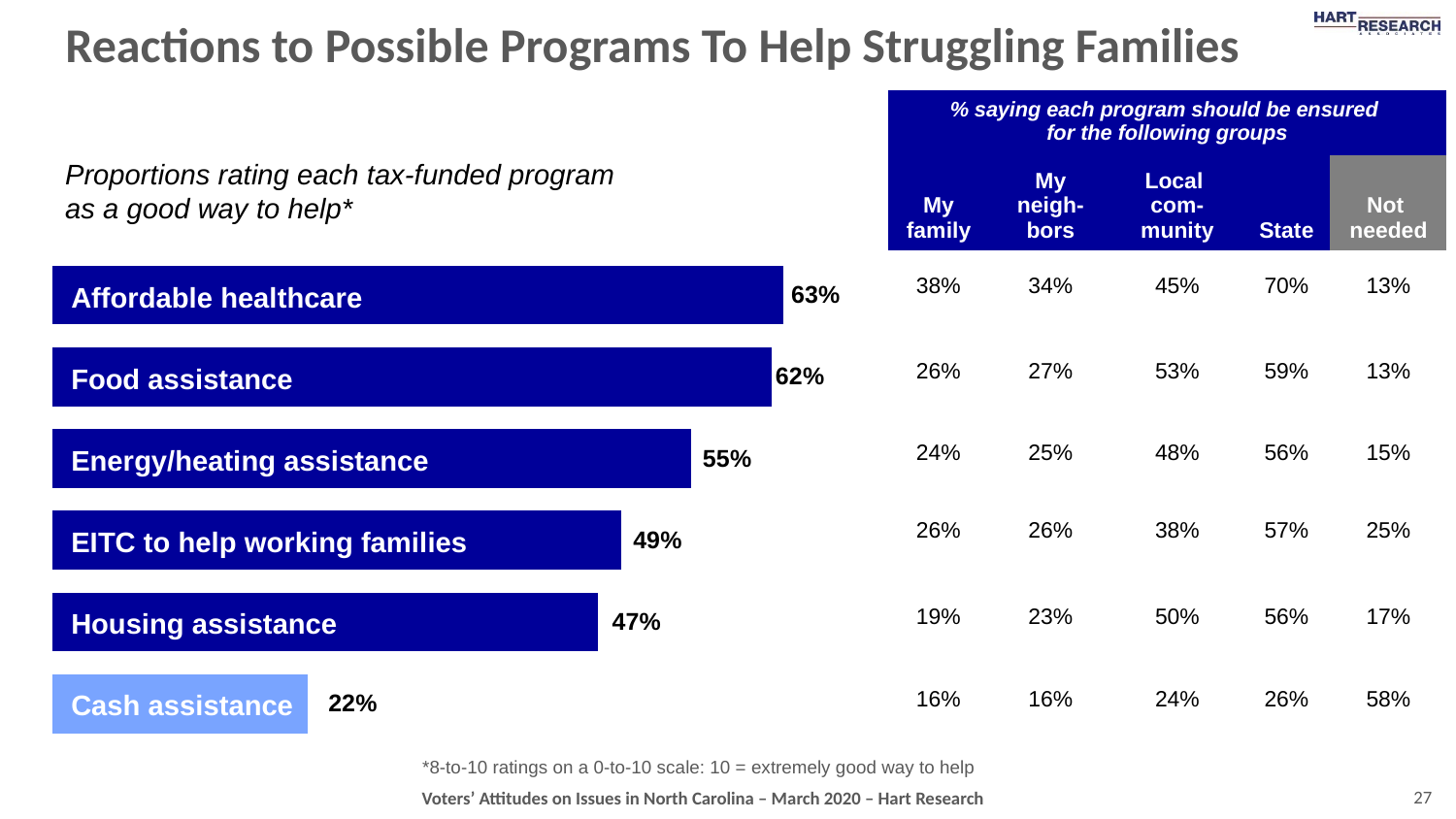
What is the difference between the values for affordable healthcare and cash assistance? 41 percentage points Which bar in the chart is shown in a lighter blue colour than the others? Cash assistance What percentage is shown for cash assistance in the bar chart? 22% How many programs are shown as bars in the chart? 6 Which program has the highest proportion rating it a good way to help? Affordable healthcare Which has a larger value in the bar chart, food assistance or energy/heating assistance? Food assistance Which has a larger value in the bar chart, EITC to help working families or housing assistance? EITC to help working families What type of chart is used to show the proportions rating each program as a good way to help? Bar chart What percentage rated affordable healthcare as a good way to help? 63% Which program has the lowest proportion rating it a good way to help? Cash assistance What is the difference between the values for energy/heating assistance and housing assistance? 8 percentage points What is the value shown for energy/heating assistance in the bar chart? 55%